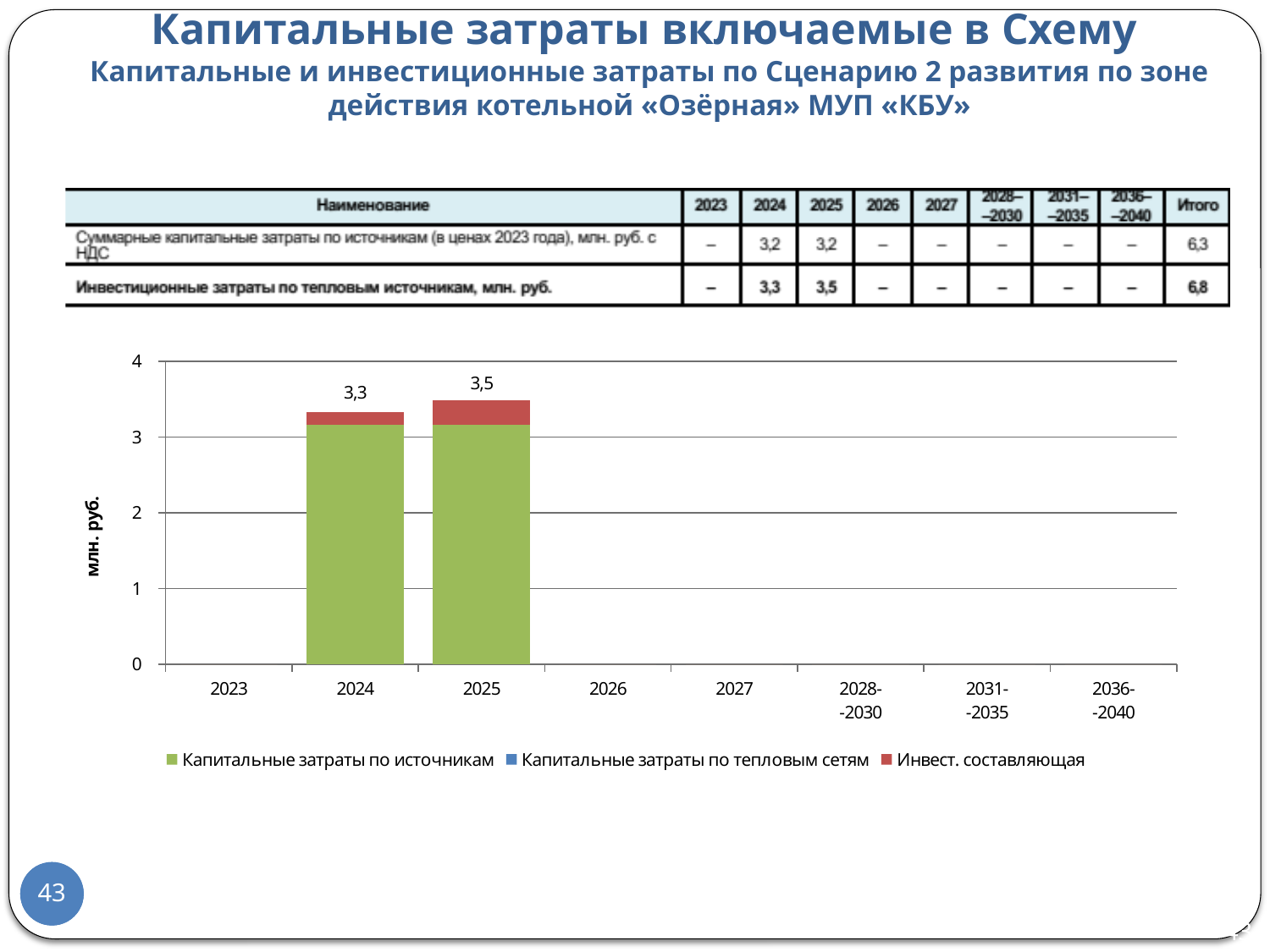
How many series does the legend list? 3 Do the total values rise or fall from 2024 to 2025? rise What is the difference between the total for 2025 and the total for 2024? 0,2 Which year has the larger total, 2024 or 2025? 2025 Is the total value for 2024 greater or less than 3? greater How many categories are shown on the x axis of the chart? 8 What kind of chart is shown on the slide? Stacked bar chart Which category has the highest total value in the chart? 2025 Which legend entry is shown in red? Инвест. составляющая What is the label of the y axis? млн. руб. What is the total value of the stacked bar for 2025? 3,5 What is the total value of the stacked bar for 2024? 3,3